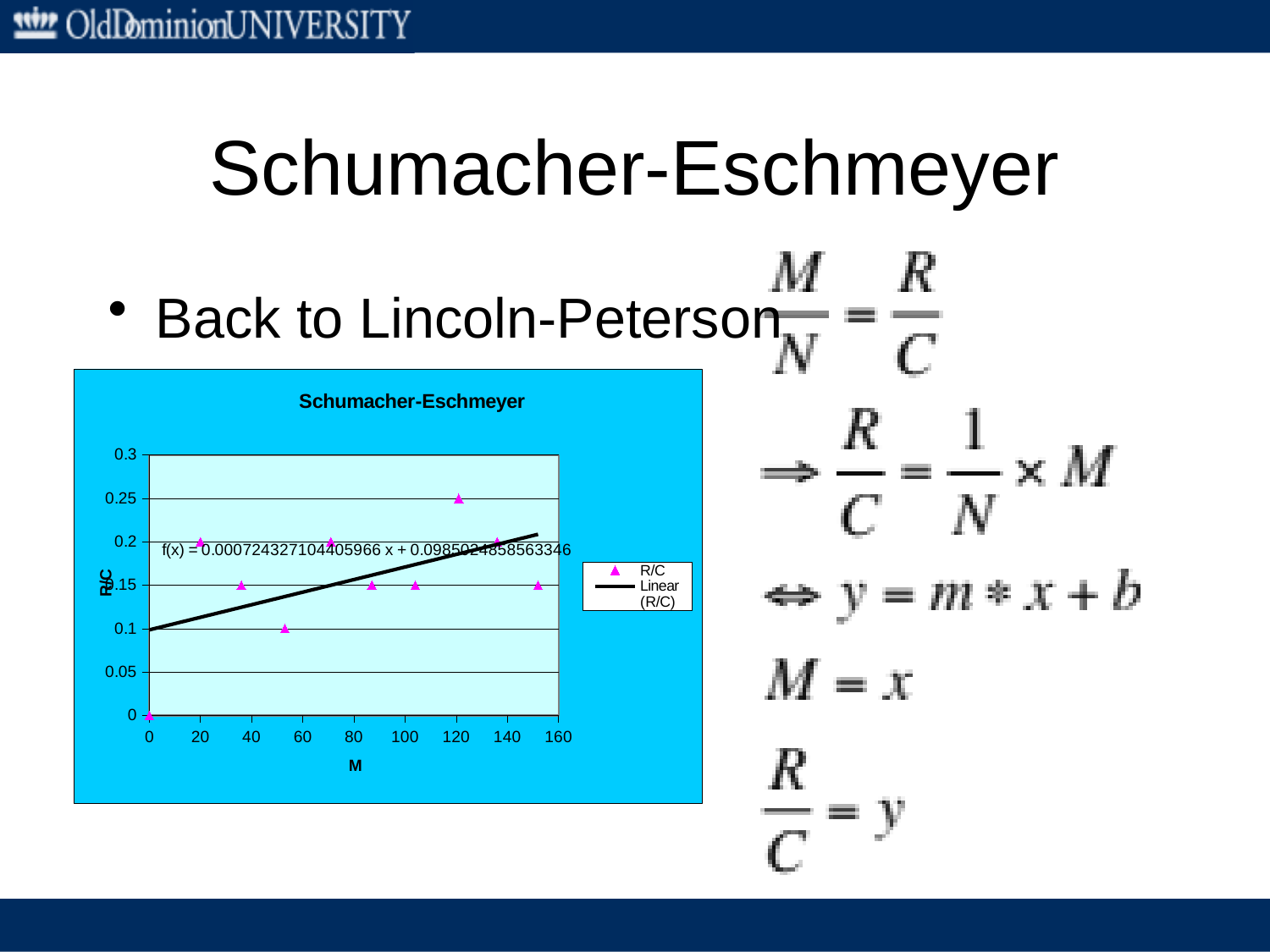
What is the lowest R/C value among the plotted points? 0 What label is on the x axis of the chart? M Is the R/C value of the point near M = 50 greater or less than 0.15? less What is the maximum value shown on the y axis of the chart? 0.3 What is the highest R/C value reached by any plotted point? 0.25 What kind of chart is shown on the slide? scatter chart Does the fitted linear trendline rise or fall as M increases? rises What is the title of the chart? Schumacher-Eschmeyer How many data points are plotted in the chart? 10 Is the R/C value of the point near M = 120 greater or less than 0.2? greater How many entries does the chart legend list? 2 Which has the larger R/C value: the point near M = 120 or the point near M = 150? the point near M = 120